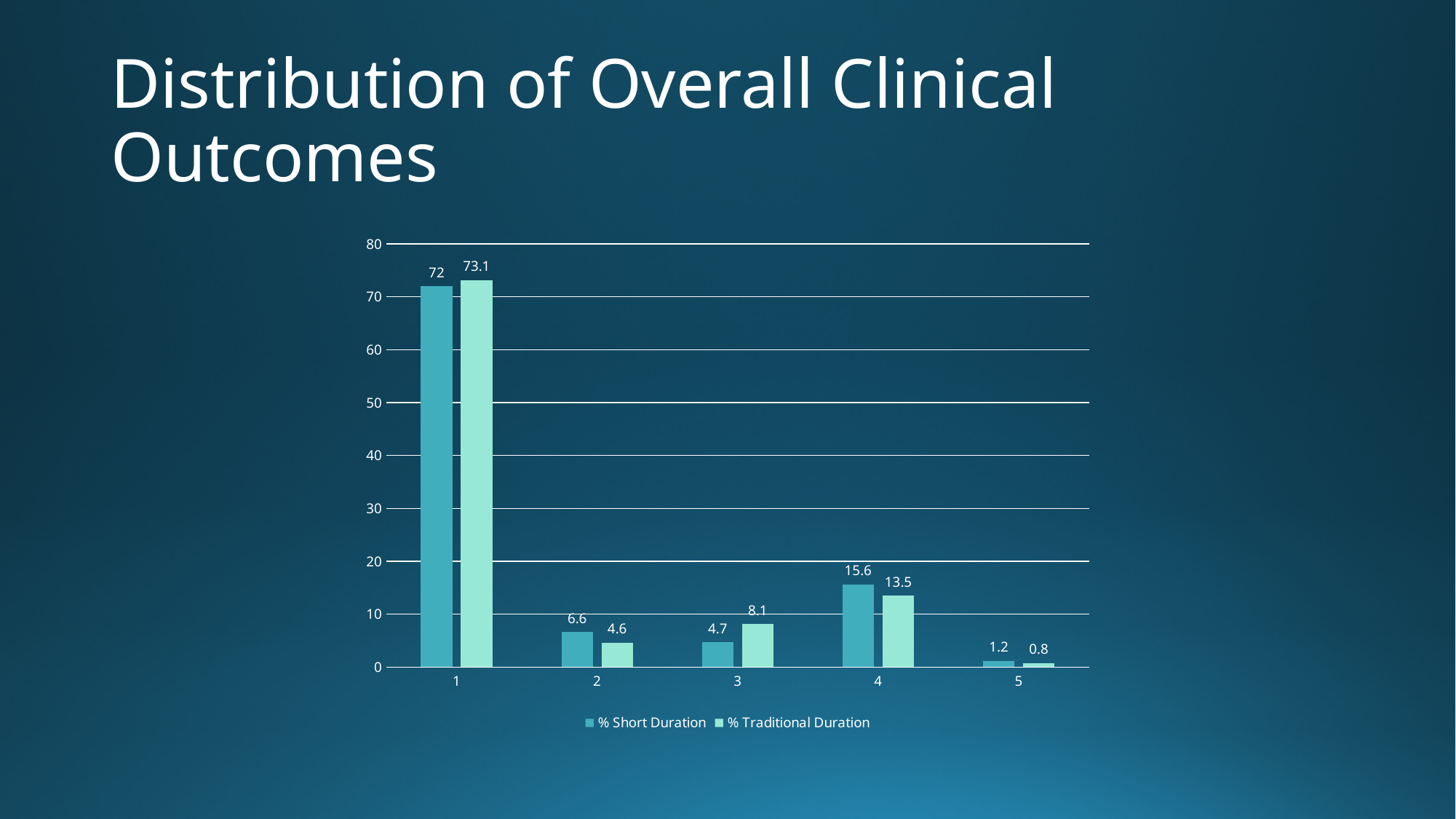
Which category has the highest % Short Duration value? 1 What kind of chart is shown on the slide? Bar chart What is the difference between the % Traditional Duration and % Short Duration values for category 1? 1.1 What is the % Traditional Duration value for category 4? 13.5 What is the % Traditional Duration value for category 3? 8.1 What is the difference between the % Short Duration and % Traditional Duration values for category 4? 2.1 Is the % Short Duration value for category 4 greater or less than 10? greater What is the % Short Duration value for category 1? 72 Which category has the lowest % Traditional Duration value? 5 How many categories are shown on the x axis? 5 For category 2, which series has the larger value, % Short Duration or % Traditional Duration? % Short Duration How many series does the legend list? 2